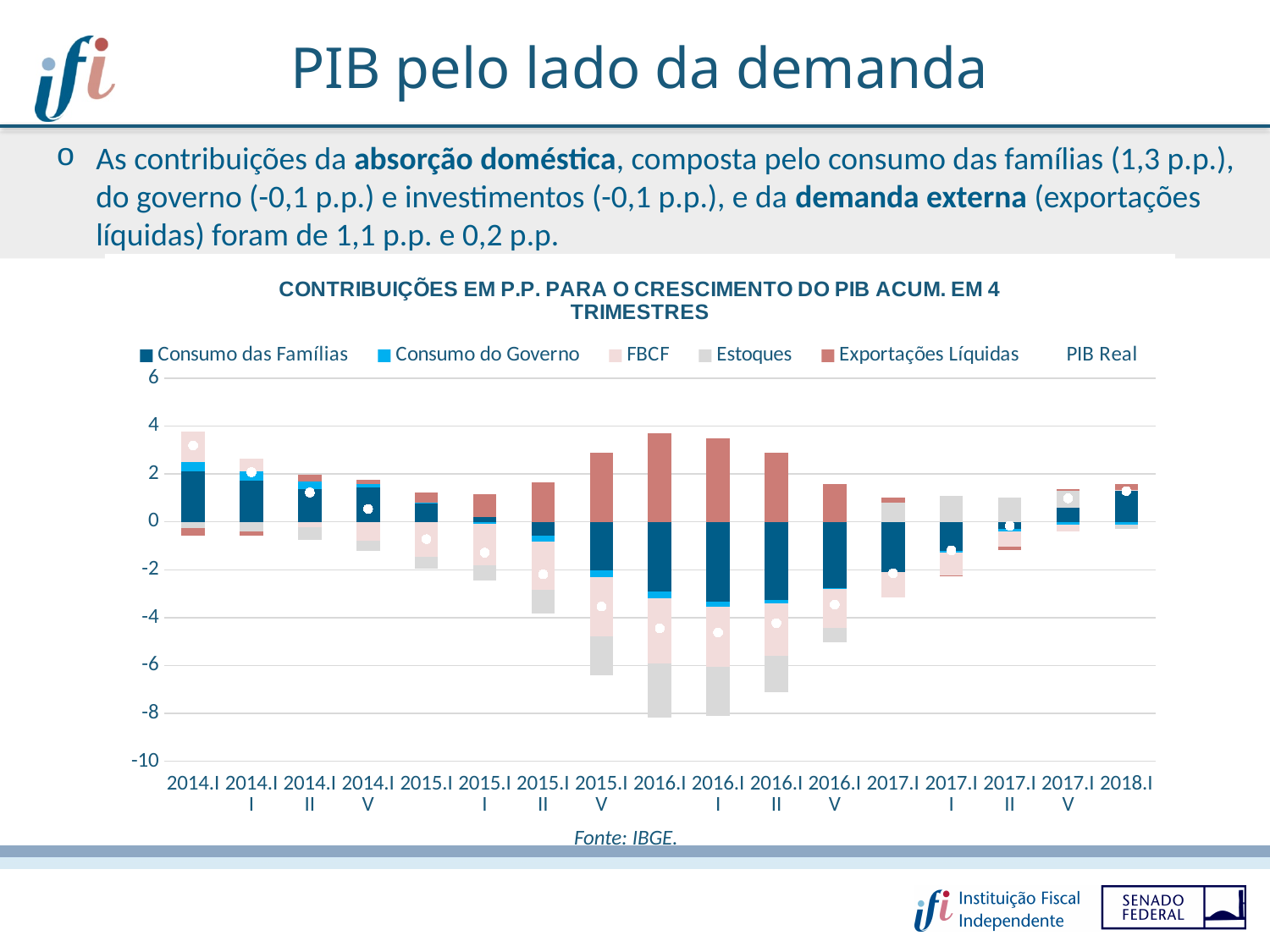
Is the Exportações Líquidas contribution for 2016.I greater or less than 2? greater Does the PIB Real series rise or fall from 2014.I to 2016.I? fall What kind of chart is shown on the slide? Stacked bar chart with a line/marker series Which has the larger Exportações Líquidas contribution, 2014.I or 2016.I? 2016.I Which has the larger Consumo das Famílias contribution, 2014.I or 2017.I? 2014.I What is the title of the chart? CONTRIBUIÇÕES EM P.P. PARA O CRESCIMENTO DO PIB ACUM. EM 4 TRIMESTRES Is the Consumo das Famílias contribution for 2016.I greater or less than -2? less How many series does the chart legend list? 6 Is the PIB Real value for 2016.I greater or less than -4? less How many quarters (categories) are plotted along the x axis? 17 Which series is shown as white circular markers rather than bars? PIB Real